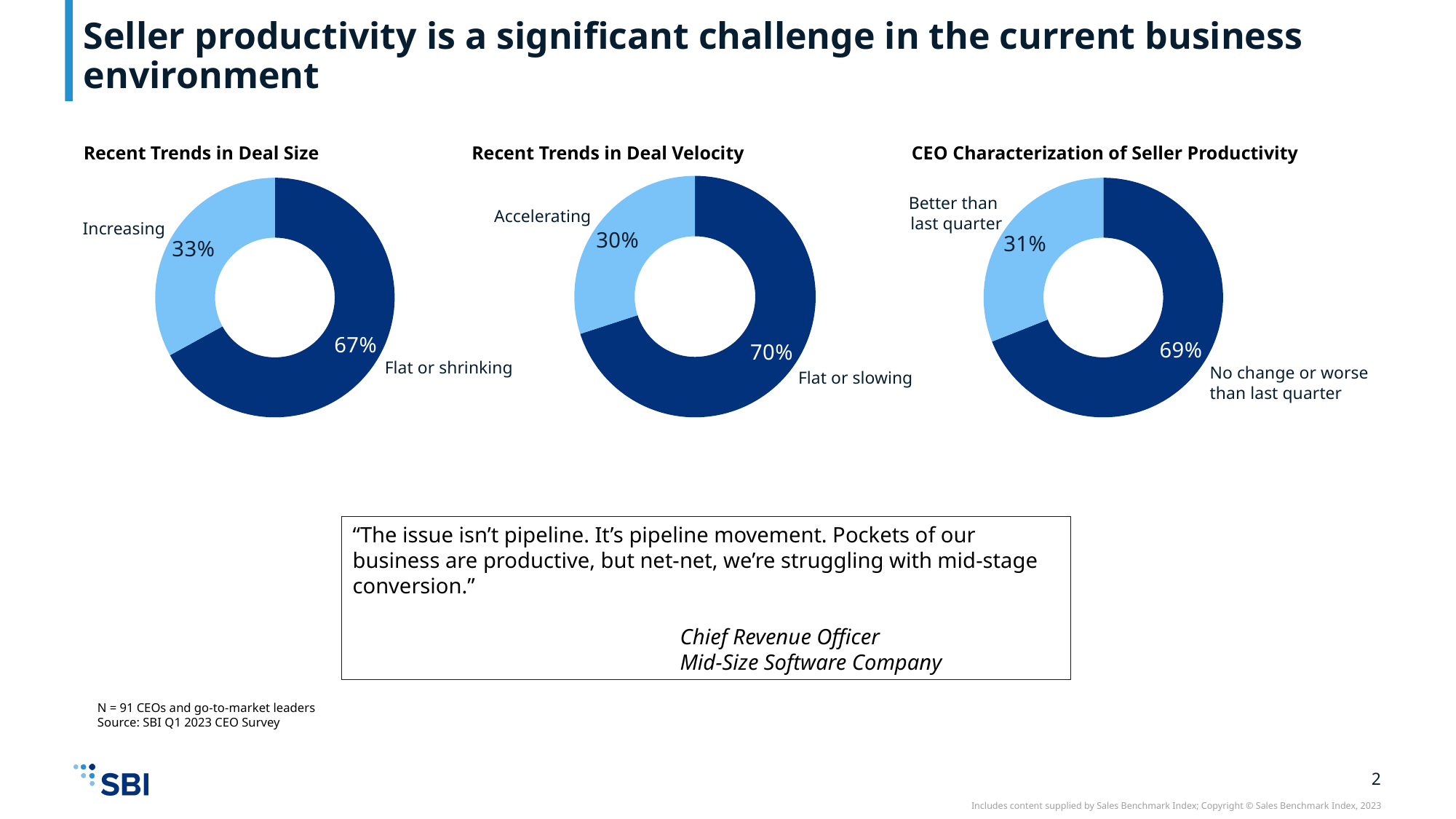
In the 'CEO Characterization of Seller Productivity' chart, which is larger: 'Better than last quarter' or 'No change or worse than last quarter'? No change or worse than last quarter In the 'Recent Trends in Deal Size' chart, what percentage is shown for 'Flat or shrinking'? 67% In the 'Recent Trends in Deal Velocity' chart, which category has the smallest share? Accelerating How many categories does the 'Recent Trends in Deal Size' chart show? 2 What type of chart is the 'CEO Characterization of Seller Productivity' chart? Doughnut chart In the 'CEO Characterization of Seller Productivity' chart, what percentage is shown for 'No change or worse than last quarter'? 69% In the 'Recent Trends in Deal Size' chart, which category has the largest share? Flat or shrinking In the 'CEO Characterization of Seller Productivity' chart, what percentage is shown for 'Better than last quarter'? 31% In the 'Recent Trends in Deal Size' chart, what percentage is shown for 'Increasing'? 33% In the 'Recent Trends in Deal Velocity' chart, what percentage is shown for 'Accelerating'? 30% In the 'Recent Trends in Deal Velocity' chart, what percentage is shown for 'Flat or slowing'? 70% In the 'Recent Trends in Deal Velocity' chart, what is the difference between 'Flat or slowing' and 'Accelerating'? 40%